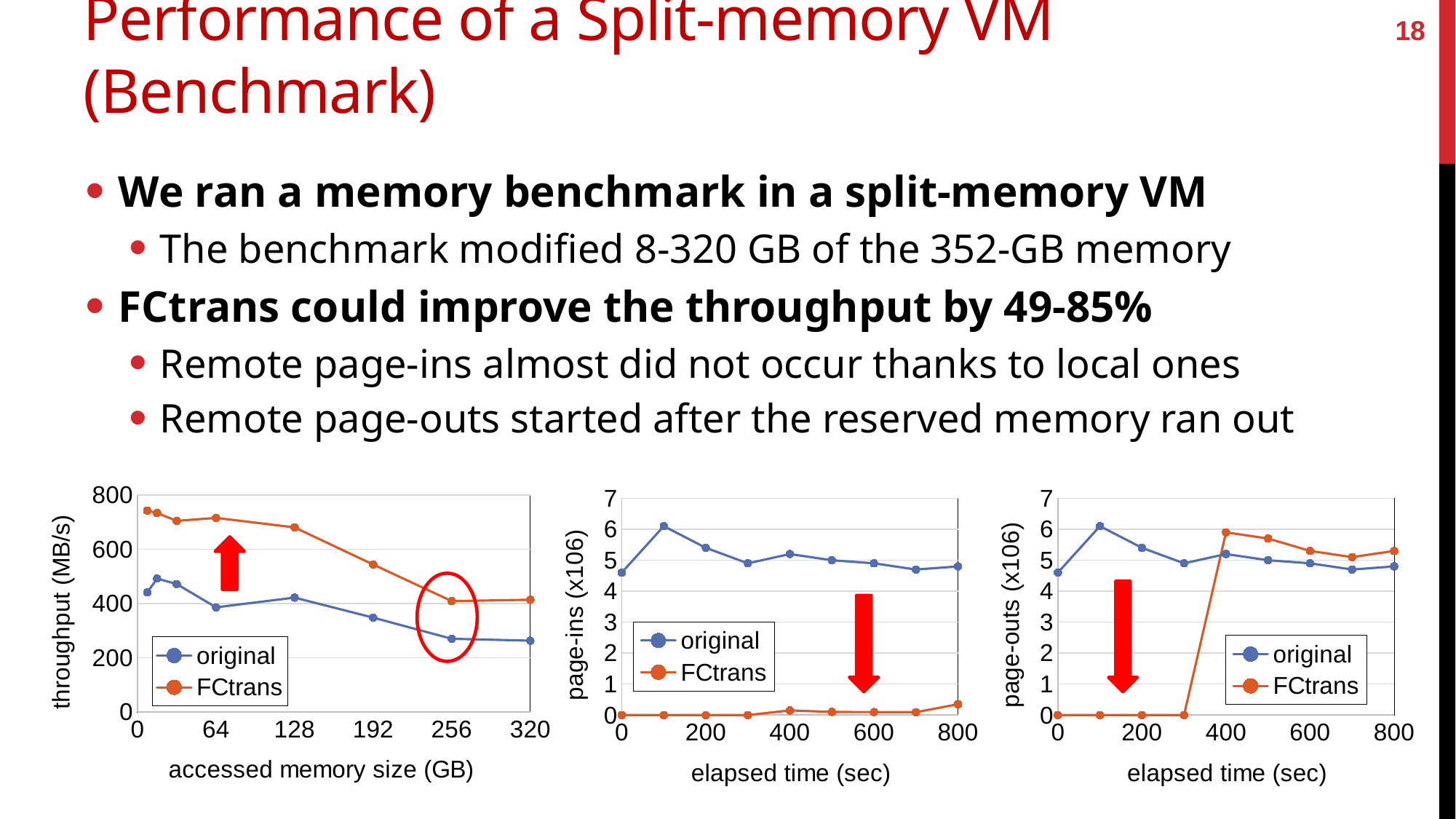
In the left throughput chart, is the original throughput at 256 GB greater or less than 400 MB/s? less In the right page-outs chart, which series has more page-outs at 400 sec, original or FCtrans? FCtrans In the middle page-ins chart, which series has more page-ins at 400 sec, original or FCtrans? original In the middle page-ins chart, is the original value at 100 sec greater or less than 5? greater How many series does the legend of the left throughput chart list? 2 In the left throughput chart, is the FCtrans throughput at 64 GB greater or less than 600 MB/s? greater In the left throughput chart, does the FCtrans throughput generally rise or fall as accessed memory size increases? fall What kind of chart is the left chart (throughput vs accessed memory size)? line chart How many data points does each series have in the right page-outs chart? 9 In the left throughput chart, which series has the higher throughput at 128 GB accessed memory, original or FCtrans? FCtrans What is the y-axis label of the middle chart? page-ins (x106)